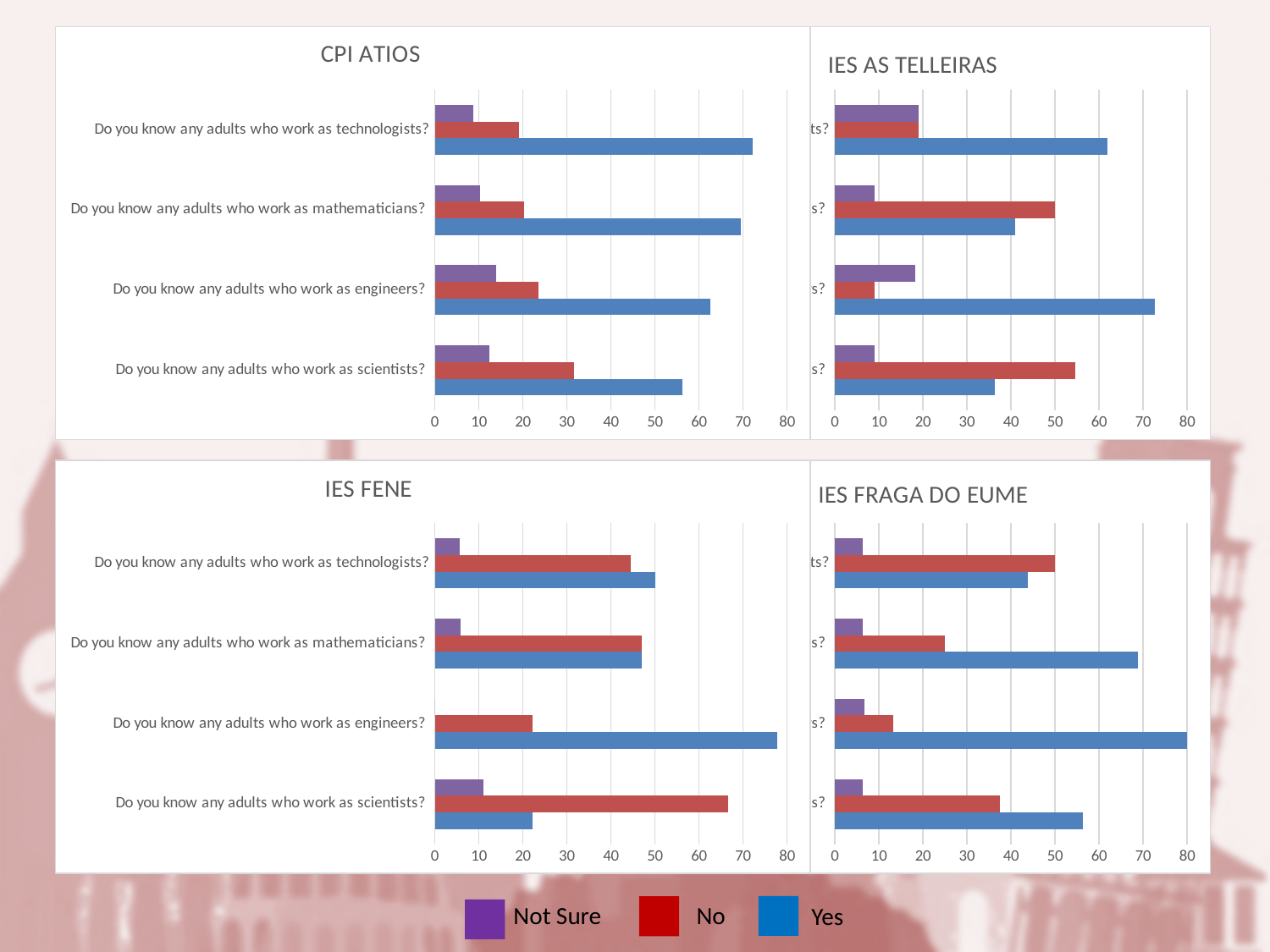
In the IES FRAGA DO EUME chart, which question has the lowest Yes value? Do you know any adults who work as technologists? How many series does the legend at the bottom of the slide list? 3 In the IES FRAGA DO EUME chart, is the Yes value for the engineers question greater or less than 70? greater In the IES AS TELLEIRAS chart, is the No value for the scientists question greater or less than 50? greater In the IES FENE chart, for the scientists question, which is larger: the No value or the Yes value? No According to the legend, which colour represents the Yes series? blue In the IES AS TELLEIRAS chart, which question has the highest Yes value? Do you know any adults who work as engineers? In the IES FENE chart, which question has the highest Yes value? Do you know any adults who work as engineers? In the CPI ATIOS chart, which question has the highest No value? Do you know any adults who work as scientists? What kind of chart is the CPI ATIOS chart? bar chart In the CPI ATIOS chart, is the Yes value for 'Do you know any adults who work as technologists?' greater or less than 60? greater How many questions (categories) are plotted in the CPI ATIOS chart? 4